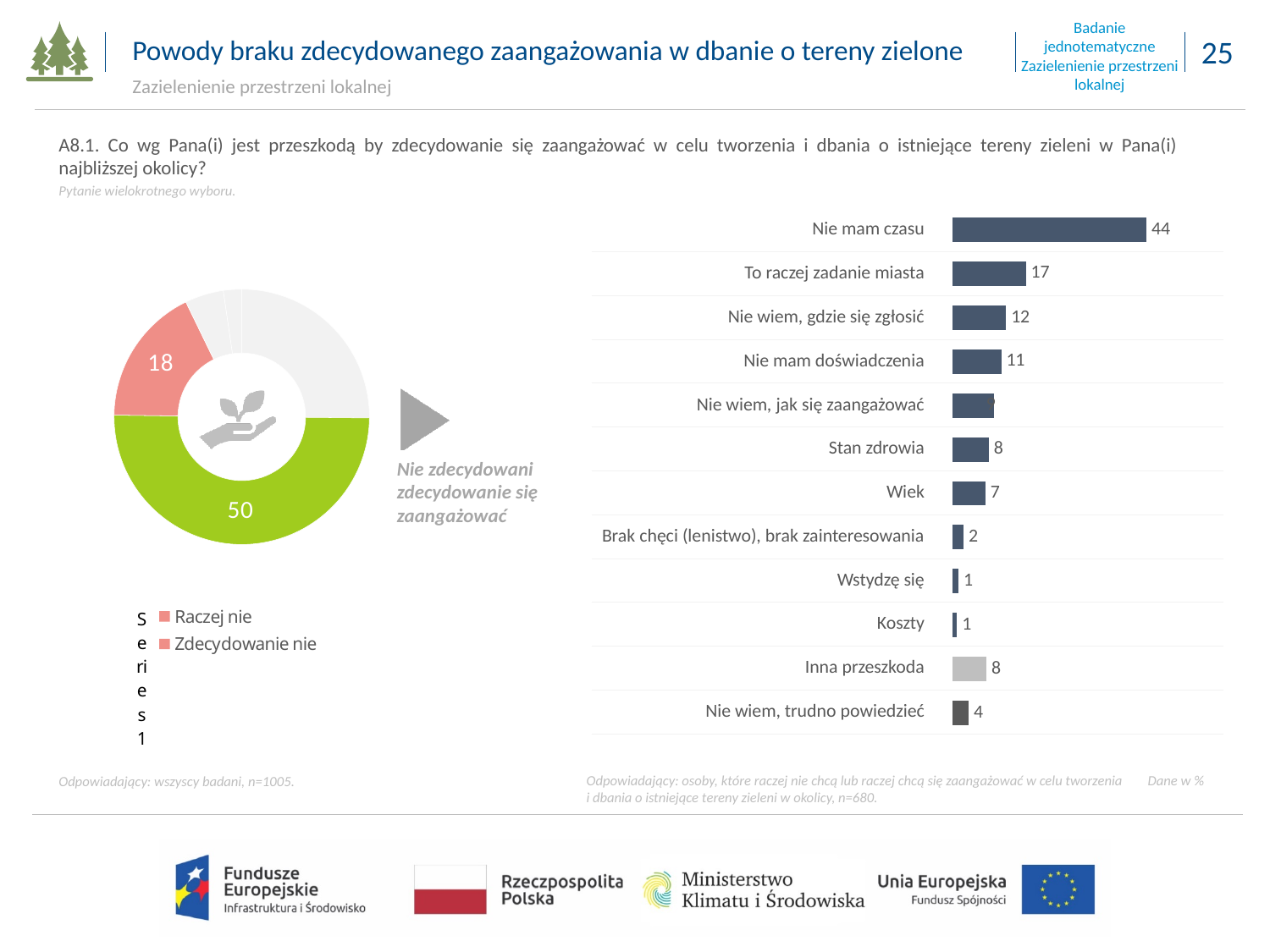
In the bar chart on the right, which is larger: "Nie wiem, gdzie się zgłosić" or "Stan zdrowia"? Nie wiem, gdzie się zgłosić In the bar chart on the right, what is the value for "Nie wiem, trudno powiedzieć"? 4 In the bar chart on the right, which category has the highest value? Nie mam czasu In the donut chart on the left, what is the value for "Raczej nie"? 18 How many categories are shown in the bar chart on the right? 12 In the bar chart on the right, what is the difference between "Nie mam czasu" and "To raczej zadanie miasta"? 27 In the bar chart on the right, what is the value for "To raczej zadanie miasta"? 17 How many entries does the legend of the donut chart on the left list? 2 In the bar chart on the right, what is the value for "Nie mam doświadczenia"? 11 What kind of chart is on the right side of the slide? Bar chart In the bar chart on the right, what is the value for "Nie mam czasu"? 44